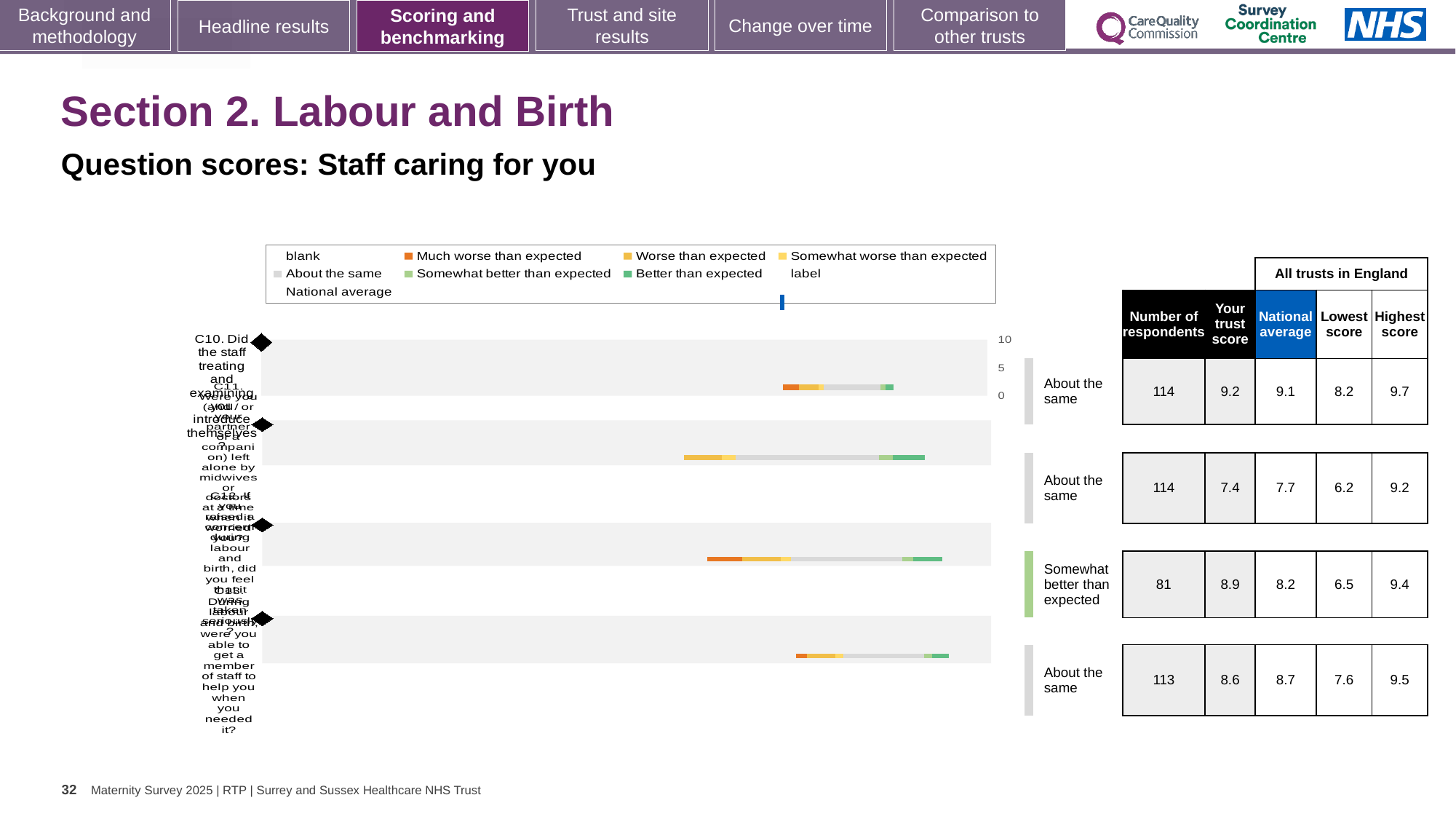
What kind of chart is shown on the slide? bar chart In the table beside the chart, what is the 'Your trust score' for the first row (C10)? 9.2 Which row has the lowest 'Your trust score' in the table beside the chart? the second row (C11), 7.4 In the table beside the chart, what is the national average for the second row (C11)? 7.7 What rating label is shown next to the third row (C12) of the chart? Somewhat better than expected Which row has the highest 'Your trust score' in the table beside the chart? the first row (C10), 9.2 How many question rows (bars) does the chart show? 4 What colour does the legend use for 'Much worse than expected'? orange For the second row (C11), which is larger: the trust score or the national average? the national average (7.7) In the table beside the chart, what is the number of respondents for the third row (C12)? 81 In the table beside the chart, what is the highest score for the fourth row (C13)? 9.5 What is the difference between the highest score and the lowest score for the first row (C10) in the table? 1.5